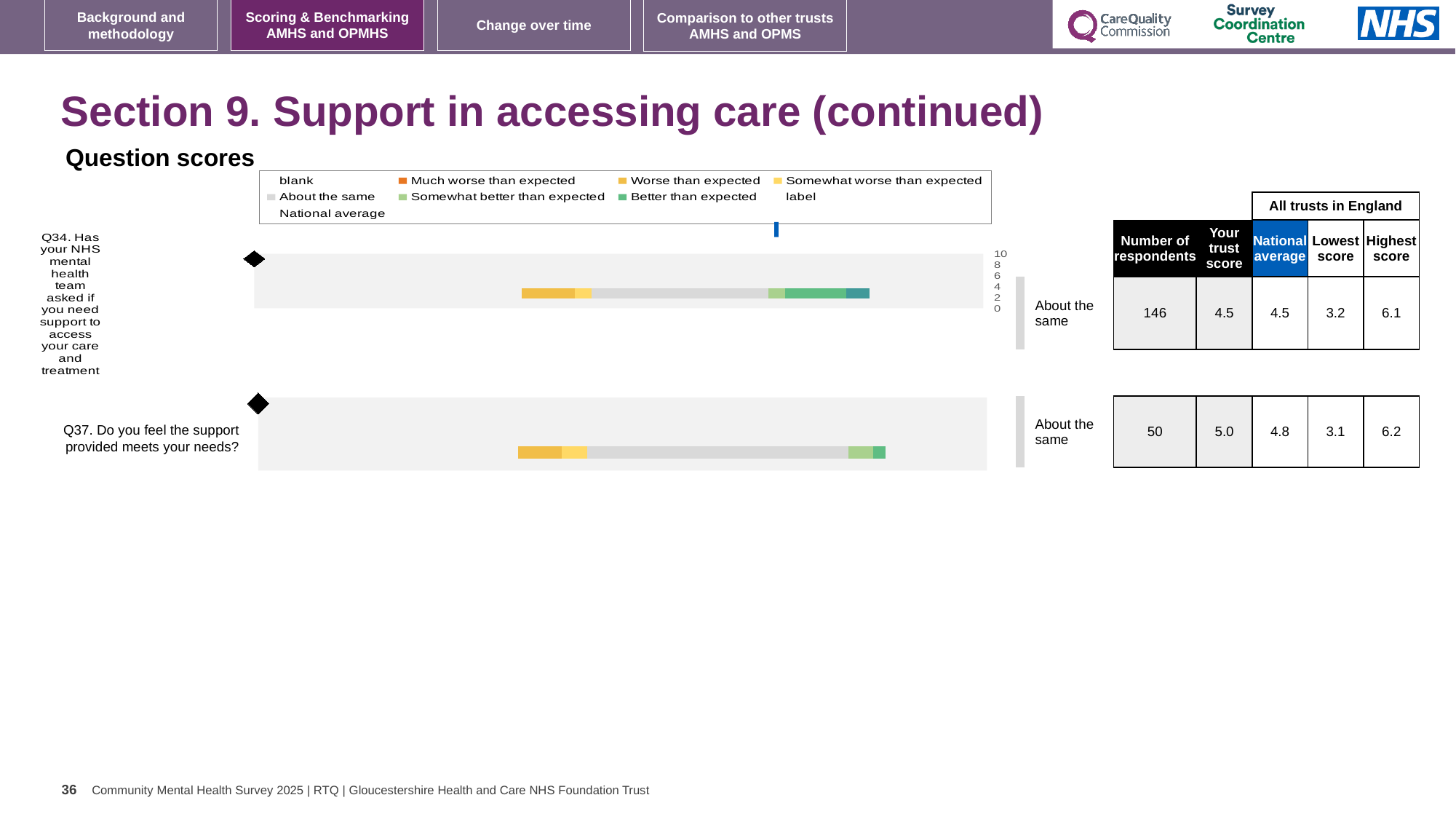
What kind of chart is used to show the question scores on this slide? bar chart In the chart legend, which entry is shown in grey? About the same What is the trust score for Q37 (Do you feel the support provided meets your needs?)? 5.0 What is the highest score among all trusts in England for Q34? 6.1 For Q37, which is larger: the trust score or the national average? trust score What is the number of respondents for Q34? 146 In the chart legend, which entry is shown in orange? Much worse than expected What is the national average score for Q37? 4.8 What is the lowest score among all trusts in England for Q37? 3.1 How many questions are plotted in the question scores chart? 2 What is the difference between the highest and lowest scores for Q37? 3.1 Which question has more respondents, Q34 or Q37? Q34